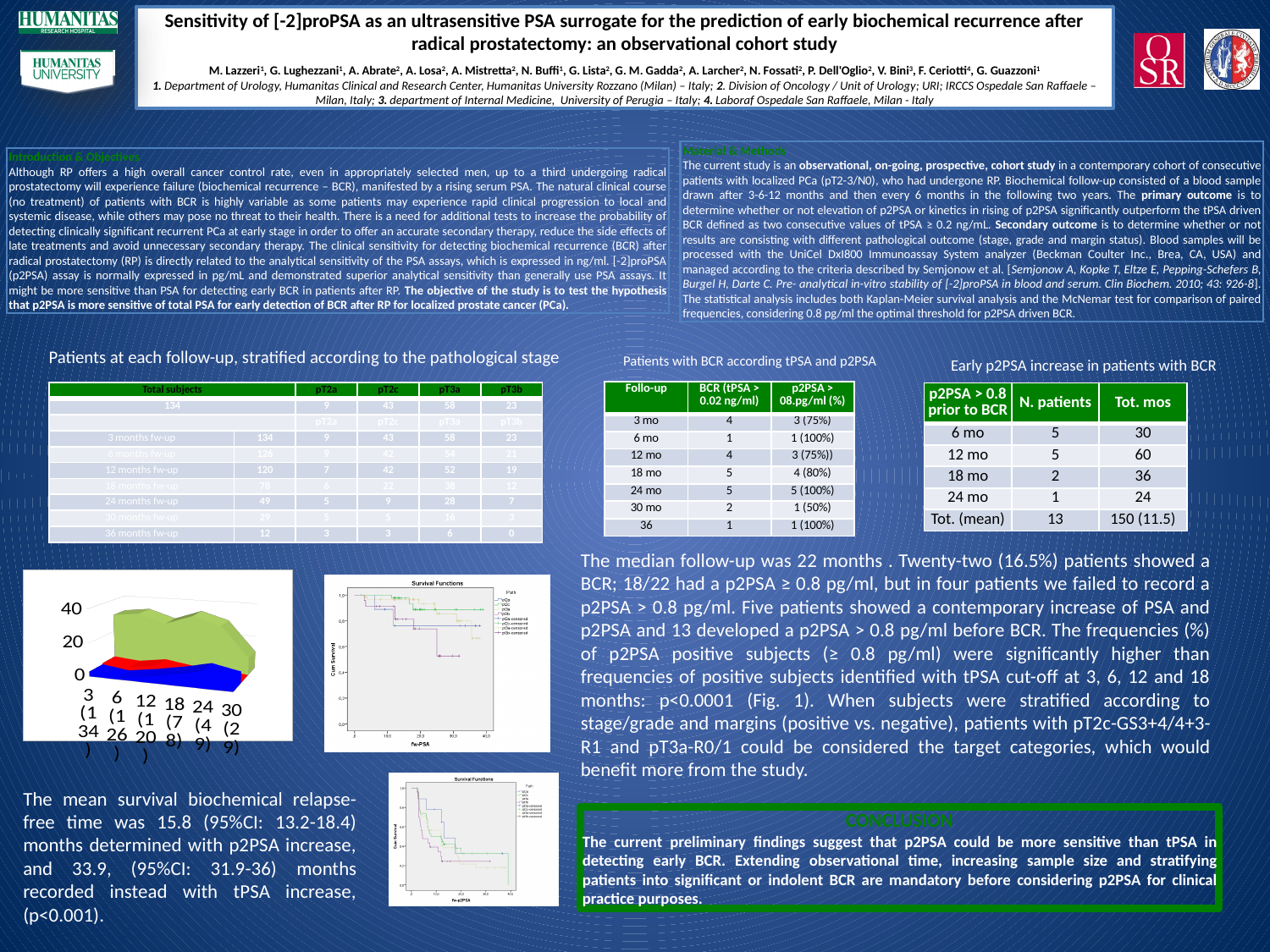
What is the title shown on the two survival curve charts on the slide? Survival Functions In the 3D area chart at the bottom left, is the value of the red series at the first category (3 (134)) greater or less than 20? less In the 3D area chart at the bottom left, is the value of the green series at the first category (3 (134)) greater or less than 20? greater What kind of chart is the 3D chart at the bottom left of the slide? area chart In the 3D area chart at the bottom left, do the values of the green series rise or fall from the first category (3 (134)) to the last category (30 (29))? fall What is the highest tick value shown on the vertical axis of the 3D area chart at the bottom left? 40 In the 3D area chart at the bottom left, is the value of the blue series at the first category (3 (134)) greater or less than 20? less In the 3D area chart at the bottom left, at the first category (3 (134)), is the green series or the red series larger? green How many categories are shown along the x axis of the 3D area chart at the bottom left? 6